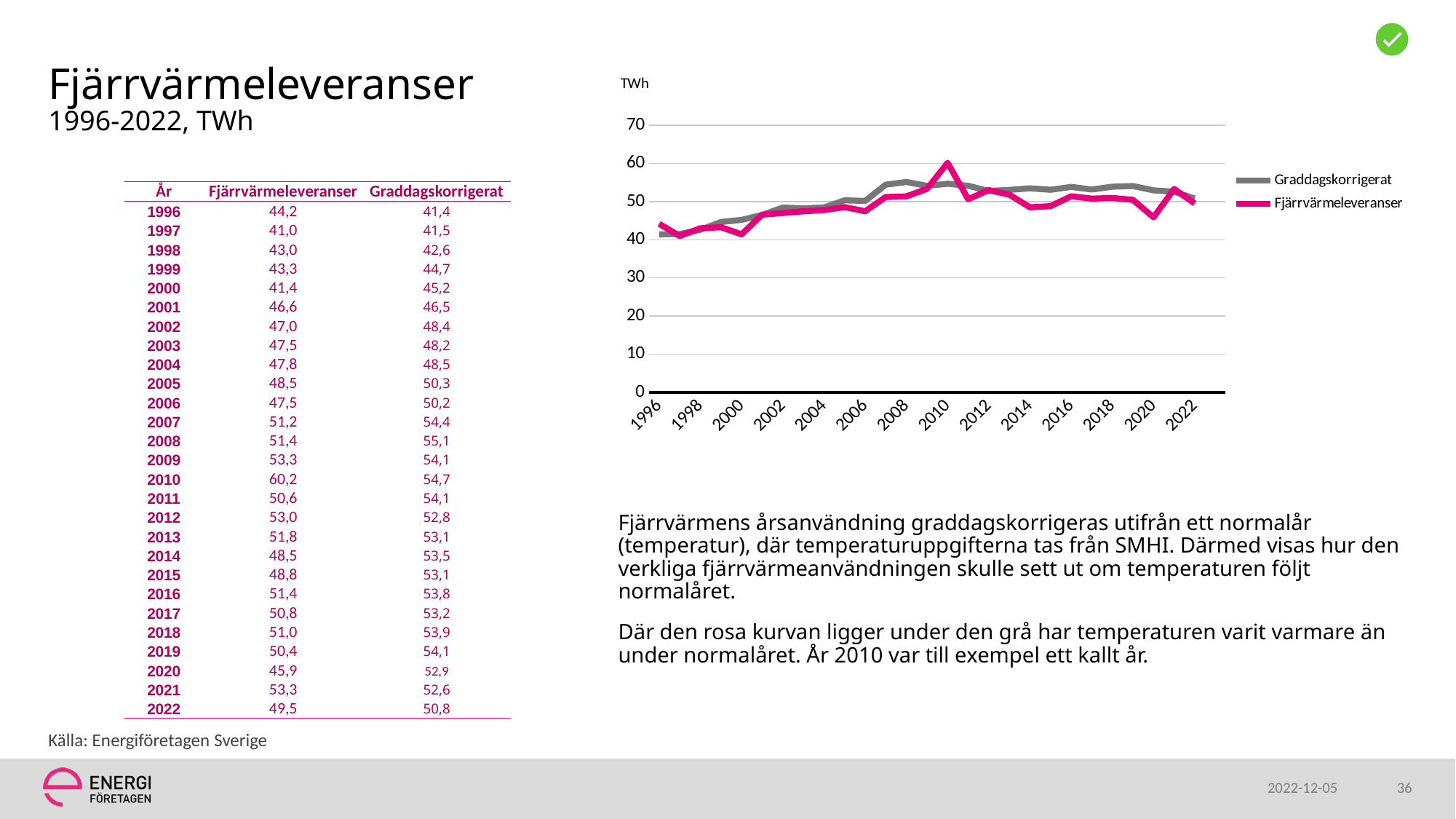
What is the Fjärrvärmeleveranser value for 2010? 60,2 In 2020, which series has the higher value, Graddagskorrigerat or Fjärrvärmeleveranser? Graddagskorrigerat What kind of chart is shown on the slide? line chart Does the Graddagskorrigerat series rise or fall from 1996 to 2008? rise How many series does the chart's legend list? 2 In which year does the Fjärrvärmeleveranser series reach its highest value? 2010 What unit is shown on the chart's vertical axis? TWh What is the difference between Fjärrvärmeleveranser and Graddagskorrigerat in 2010? 5,5 Is the Graddagskorrigerat value for 2010 greater or less than 60? less What is the Graddagskorrigerat value for 2022? 50,8 In which year is the Fjärrvärmeleveranser value lowest? 1997 What are the two series named in the chart's legend? Graddagskorrigerat and Fjärrvärmeleveranser